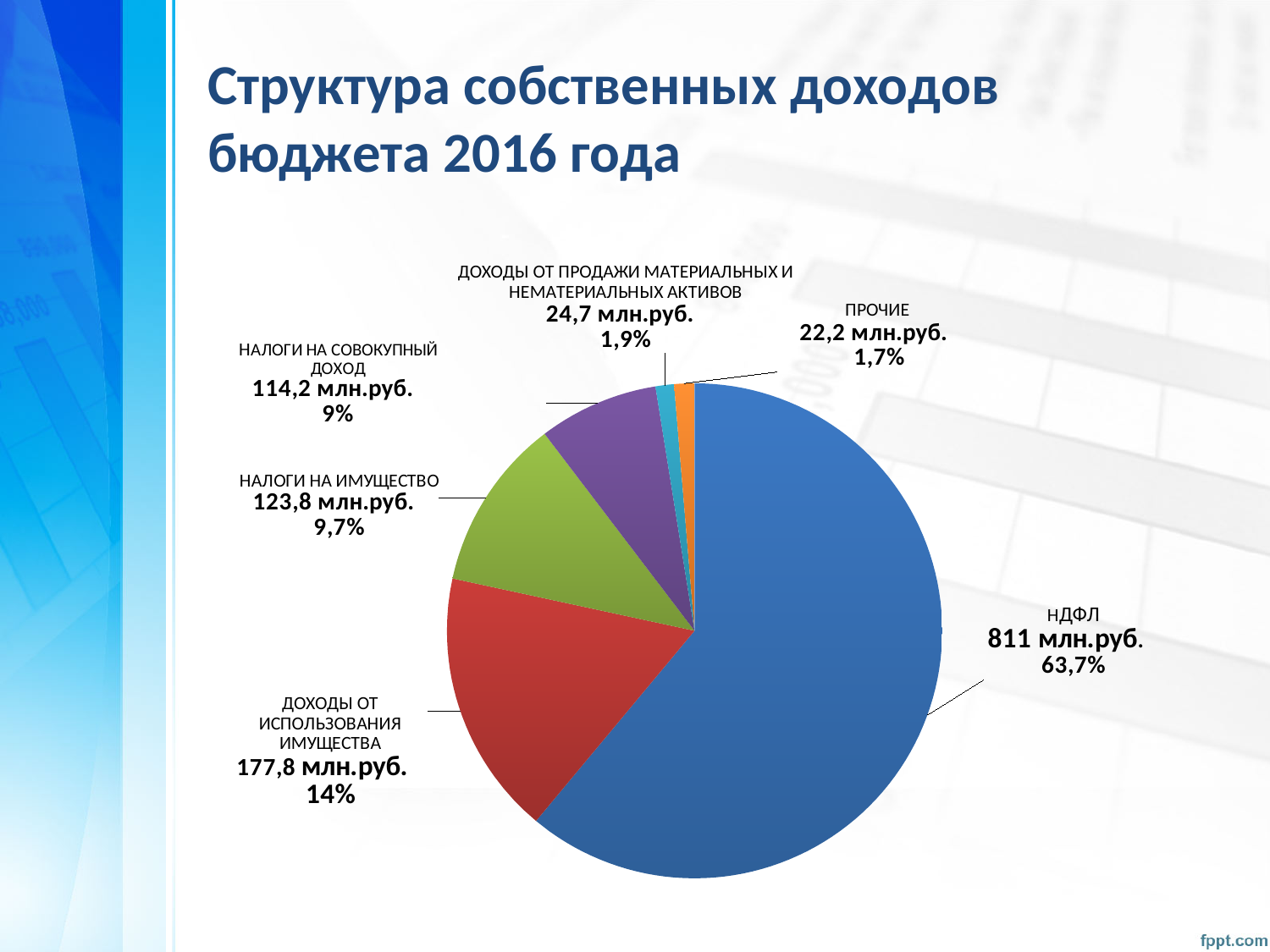
What is the title of the slide? Структура собственных доходов бюджета 2016 года Which category has the smallest slice of the pie? ПРОЧИЕ How many slices does the pie chart have? 6 What is the difference in percentage points between ДОХОДЫ ОТ ИСПОЛЬЗОВАНИЯ ИМУЩЕСТВА (14%) and НАЛОГИ НА ИМУЩЕСТВО (9,7%)? 4,3% What percentage is shown for НАЛОГИ НА ИМУЩЕСТВО? 9,7% What is the value for НДФЛ? 811 млн.руб. What is the value for ДОХОДЫ ОТ ИСПОЛЬЗОВАНИЯ ИМУЩЕСТВА? 177,8 млн.руб. What share of the pie does НДФЛ represent? 63,7% Which category has the largest slice of the pie? НДФЛ Which is larger: НАЛОГИ НА ИМУЩЕСТВО or НАЛОГИ НА СОВОКУПНЫЙ ДОХОД? НАЛОГИ НА ИМУЩЕСТВО What kind of chart is shown on the slide? Pie chart What is the value for НАЛОГИ НА СОВОКУПНЫЙ ДОХОД? 114,2 млн.руб.